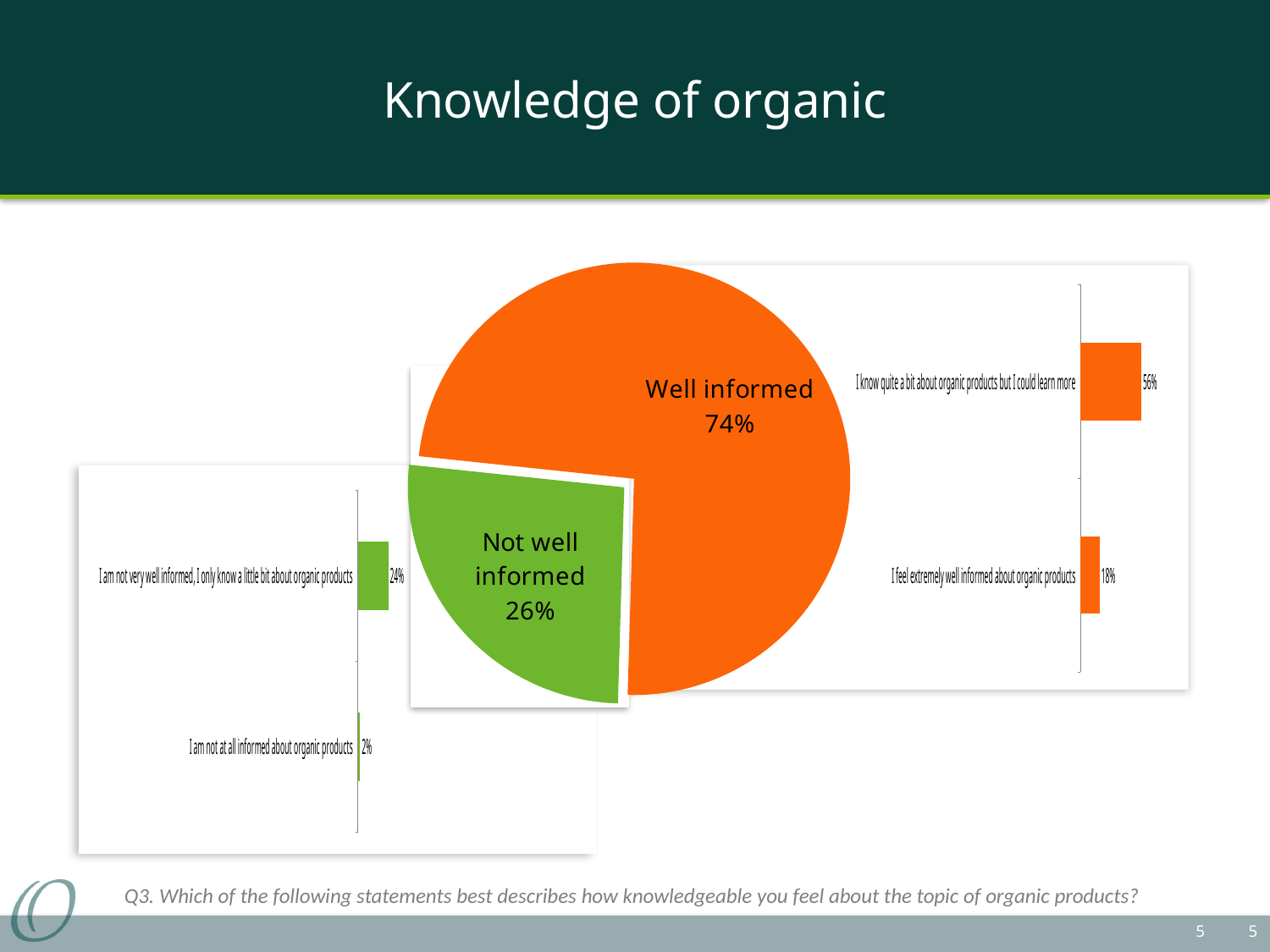
In the green bar chart on the left of the slide, what is the difference in percentage points between the two bars? 22 In the pie chart in the centre of the slide, how many slices are there? 2 In the pie chart in the centre of the slide, what share is labelled 'Well informed'? 74% In the pie chart in the centre of the slide, which slice is larger, 'Well informed' or 'Not well informed'? Well informed In the orange bar chart on the right of the slide, which statement has the highest value? I know quite a bit about organic products but I could learn more In the green bar chart on the left of the slide, what is the value for 'I am not at all informed about organic products'? 2% In the orange bar chart on the right of the slide, what is the value for 'I know quite a bit about organic products but I could learn more'? 56% What kind of chart is shown in the centre of the slide? Pie chart In the green bar chart on the left of the slide, what is the value for 'I am not very well informed, I only know a little bit about organic products'? 24% In the orange bar chart on the right of the slide, what is the value for 'I feel extremely well informed about organic products'? 18% In the pie chart in the centre of the slide, what is the difference in percentage points between 'Well informed' and 'Not well informed'? 48 In the pie chart in the centre of the slide, what share is labelled 'Not well informed'? 26%